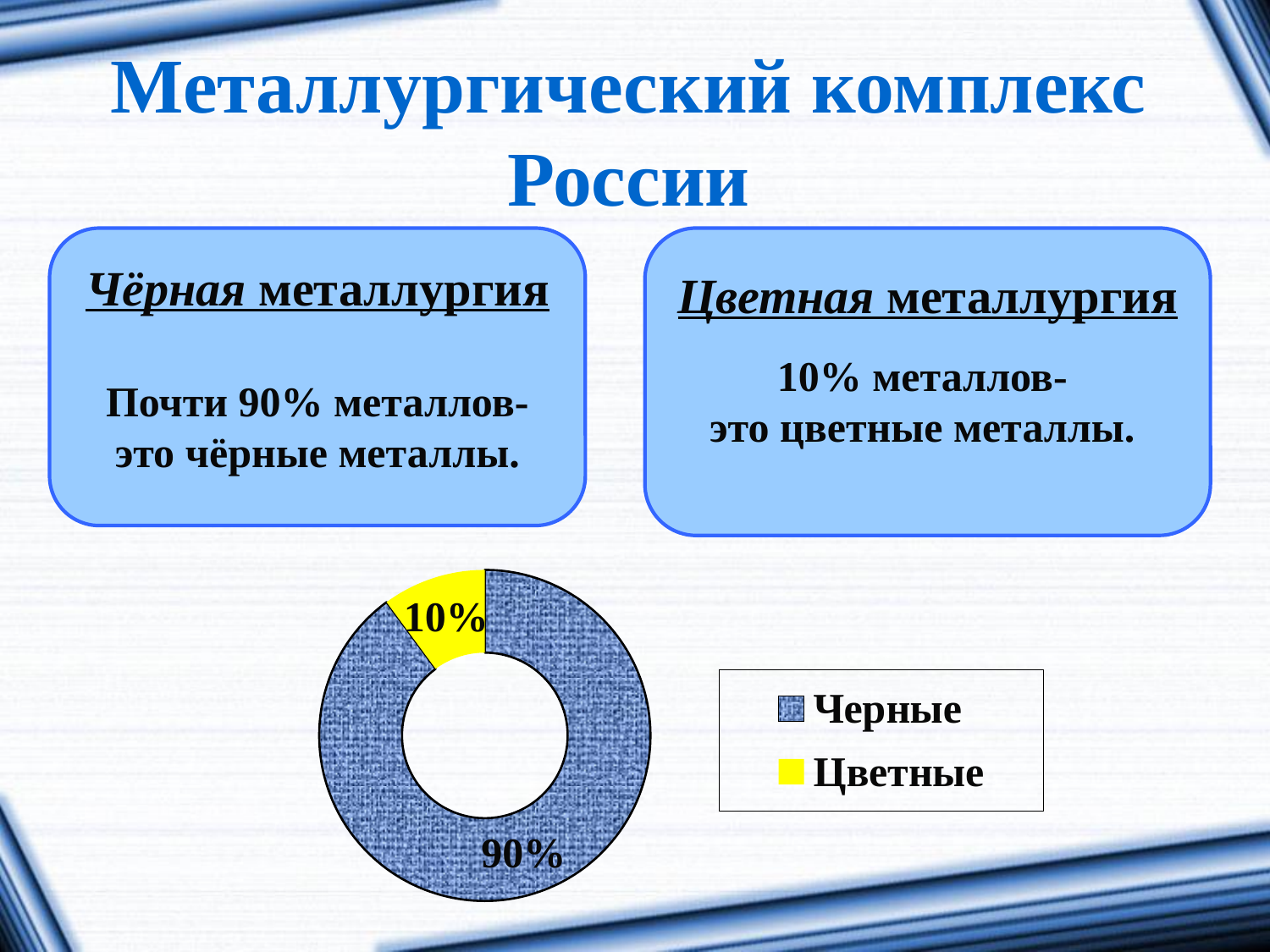
What share of the chart does the Черные segment represent? 90% What is the difference in percentage points between the Черные and Цветные shares? 80 What share of the chart does the Цветные segment represent? 10% What kind of chart is shown on the slide? Doughnut chart How many categories are shown in the chart? 2 Which category has the largest share in the chart? Черные Which category has the smallest share in the chart? Цветные What colour is the Цветные segment in the chart? Yellow How many entries does the legend list? 2 Which is larger, the share for Черные or the share for Цветные? Черные What is the total of the two shares shown in the chart? 100%